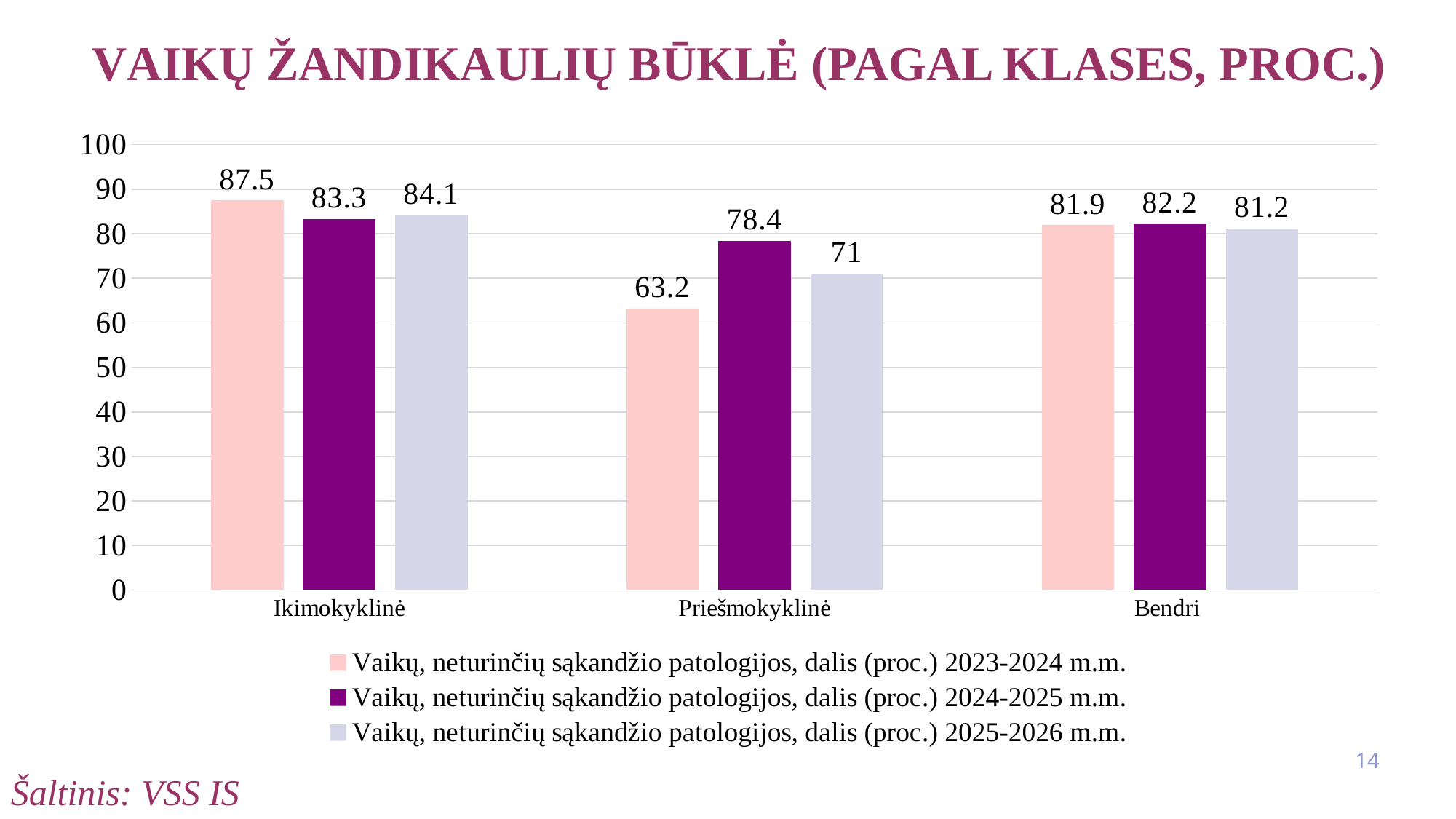
Which is larger for Ikimokyklinė: the 2023-2024 m.m. value or the 2024-2025 m.m. value? 2023-2024 m.m. Which category has the highest value in the 2025-2026 m.m. series? Ikimokyklinė What is the value for Bendri in the 2024-2025 m.m. series? 82.2 Which category has the lowest value in the 2023-2024 m.m. series? Priešmokyklinė What is the value for Priešmokyklinė in the 2025-2026 m.m. series? 71 What is the value for Ikimokyklinė in the 2023-2024 m.m. series? 87.5 What is the difference between the 2024-2025 m.m. and 2023-2024 m.m. values for Priešmokyklinė? 15.2 What is the source cited at the bottom of the slide? VSS IS How many series does the legend list? 3 How many categories are shown on the x axis? 3 What kind of chart is shown on the slide? bar chart Is the value for Priešmokyklinė in the 2023-2024 m.m. series greater or less than 70? less